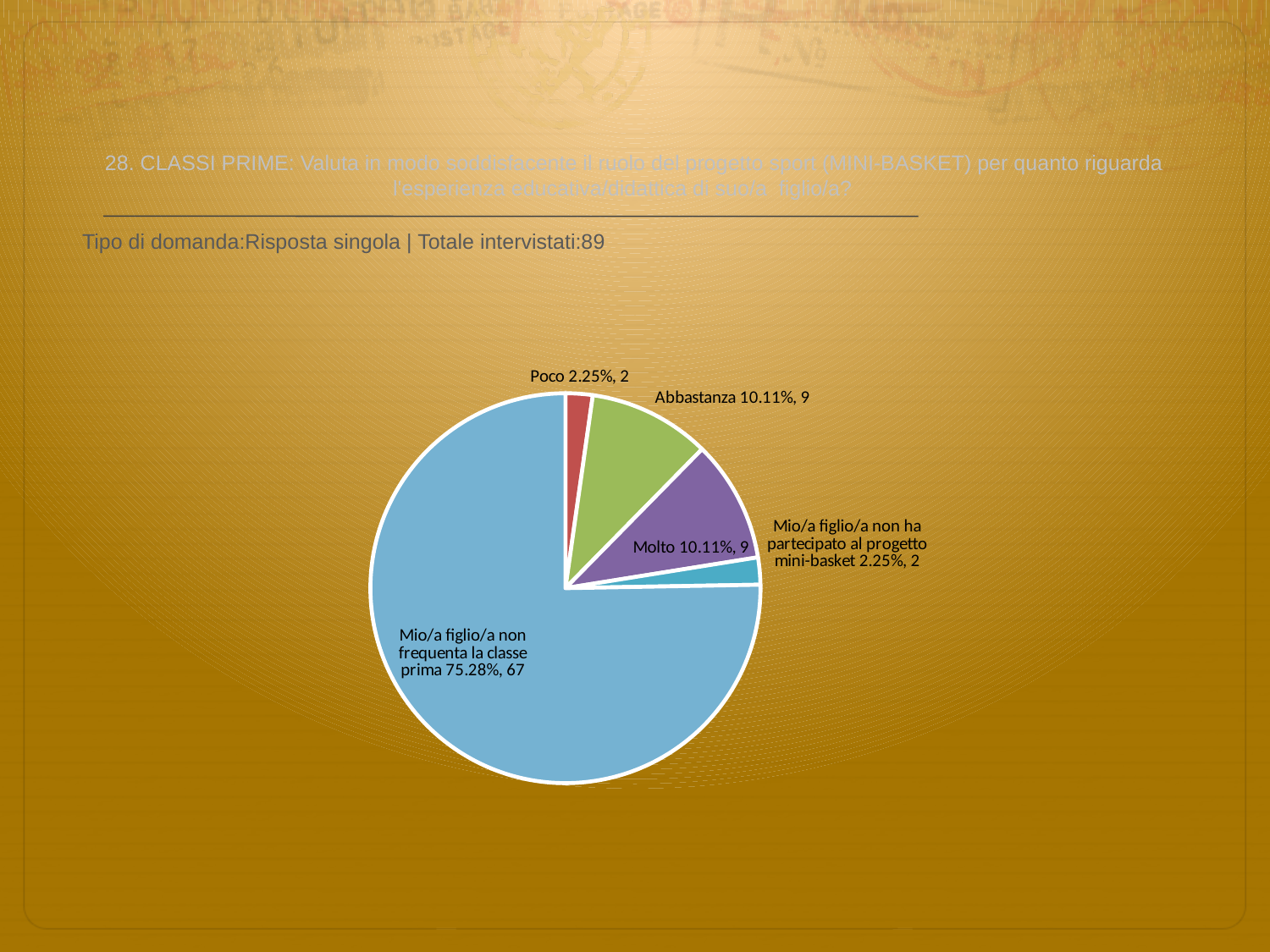
What is the difference in respondent count between 'Mio/a figlio/a non frequenta la classe prima' and 'Molto'? 58 What is the total number of respondents stated on the slide (Totale intervistati)? 89 How many respondents chose 'Abbastanza'? 9 What kind of chart is shown on the slide? pie chart What share of the pie does the 'Abbastanza' slice represent? 10.11% What share of the pie does the 'Poco' slice represent? 2.25% What share of the pie does the 'Molto' slice represent? 10.11% Which category has the largest slice of the pie? Mio/a figlio/a non frequenta la classe prima How many slices does the pie chart have? 5 How many respondents chose 'Mio/a figlio/a non ha partecipato al progetto mini-basket'? 2 How many respondents chose 'Mio/a figlio/a non frequenta la classe prima'? 67 Which slice is larger, 'Abbastanza' or 'Poco'? Abbastanza